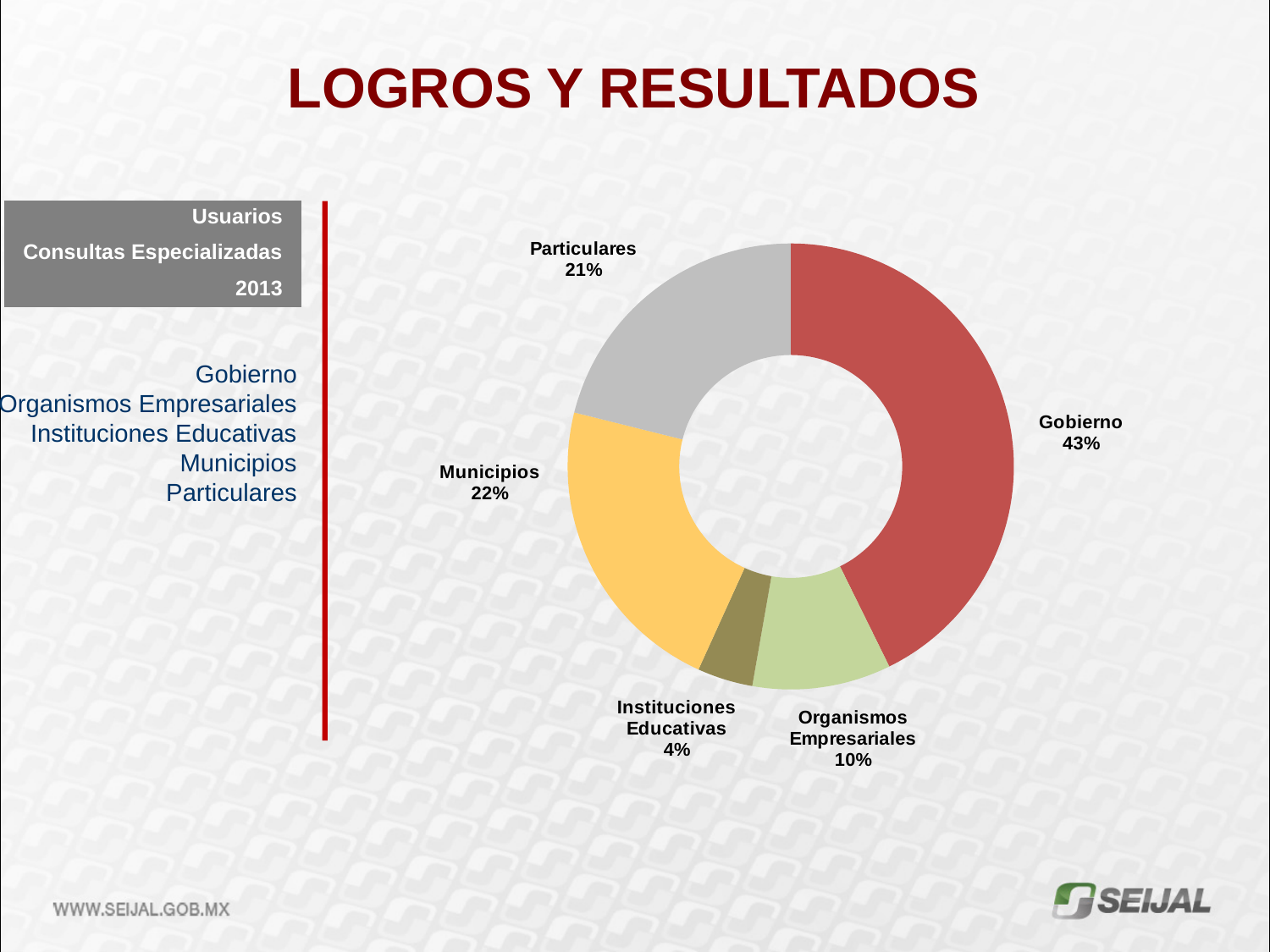
What percentage is shown for Organismos Empresariales? 10% What percentage is shown for Instituciones Educativas? 4% Which is larger, the share for Organismos Empresariales or the share for Instituciones Educativas? Organismos Empresariales What is the difference in percentage points between Gobierno and Municipios? 21 What kind of chart is shown on the slide? Pie chart (doughnut) What percentage is shown for Particulares? 21% What share of the chart does Gobierno represent? 43% What percentage is shown for Municipios? 22% What colour is the Gobierno segment of the chart? Red Which category has the smallest share of the chart? Instituciones Educativas How many categories are shown in the chart? 5 Which category has the largest share of the chart? Gobierno